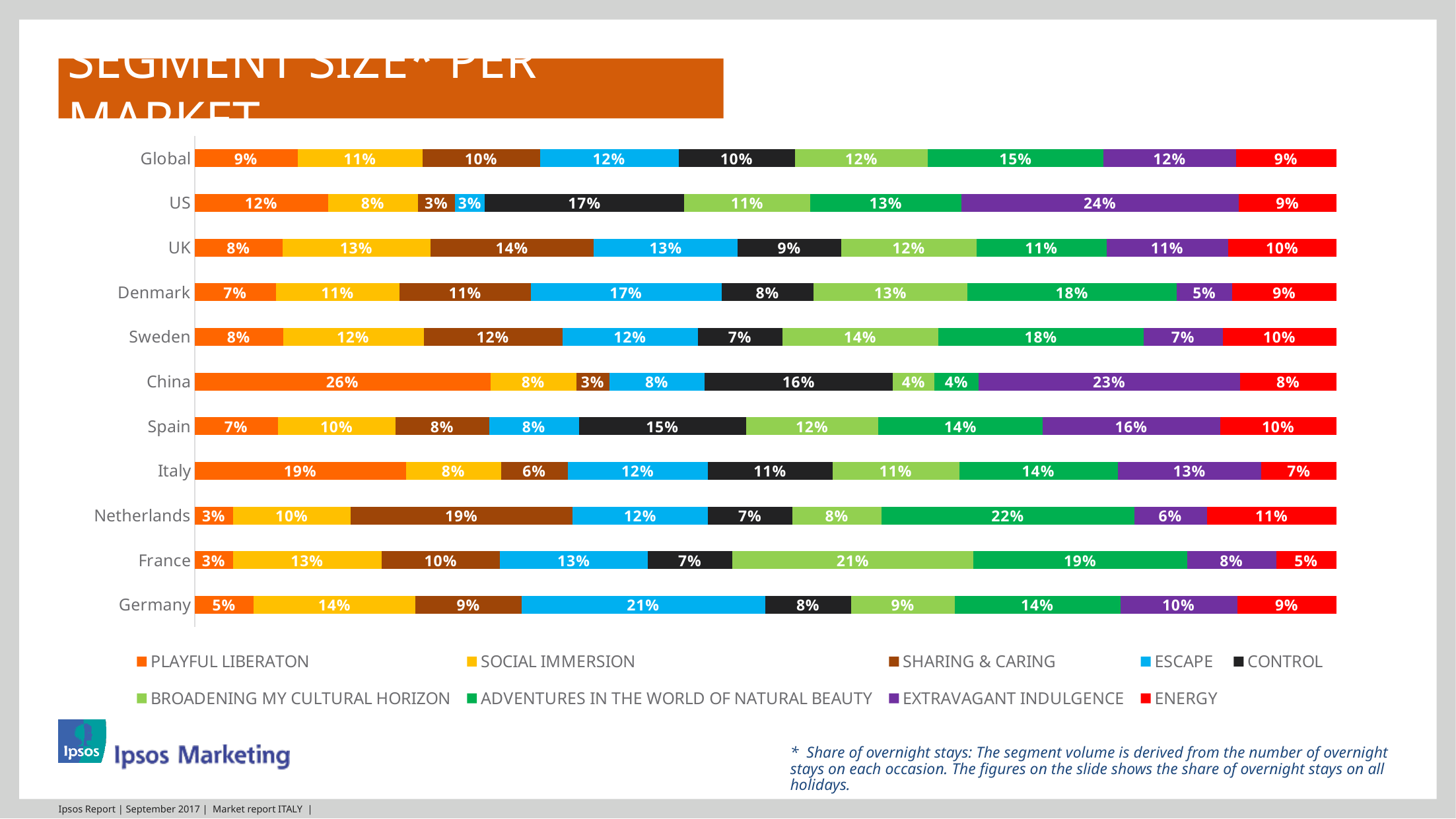
Which has a larger value for BROADENING MY CULTURAL HORIZON, France or Germany? France What kind of chart is shown on the slide? Stacked bar chart What is the difference between the CONTROL value for the US and the CONTROL value for Global? 7 percentage points How many series does the legend list? 9 How many markets are shown on the chart? 11 What is the value for ESCAPE in Germany? 21% What is the value for SHARING & CARING in the Netherlands? 19% Which market has the lowest value for ENERGY? France Which market has the highest value for ADVENTURES IN THE WORLD OF NATURAL BEAUTY? Netherlands What is the value for PLAYFUL LIBERATON in China? 26% What is the value for EXTRAVAGANT INDULGENCE in the US? 24% What colour represents the ENERGY segment in the chart? Red